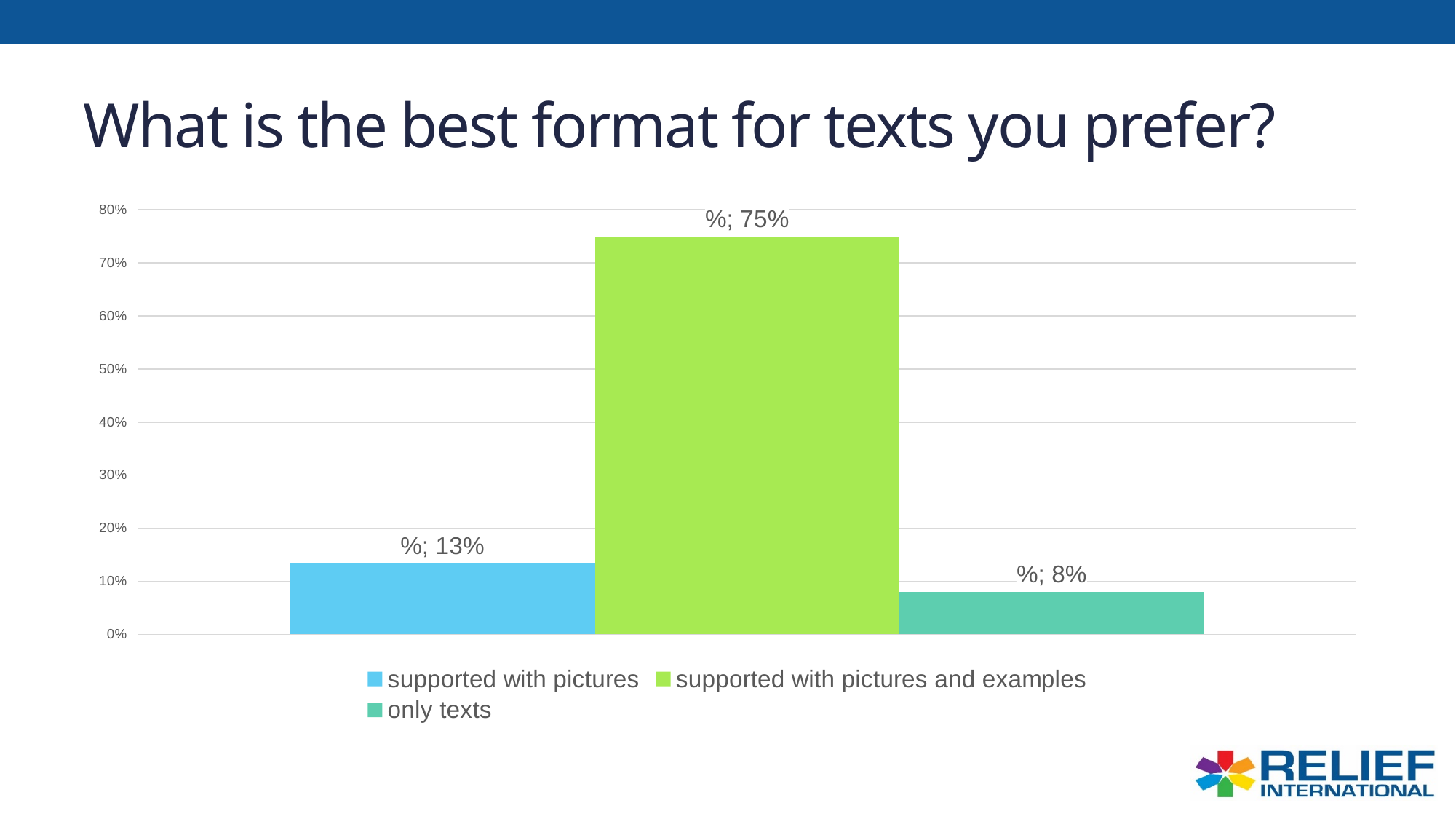
Which category has the lowest value? only texts Which category has the highest value? supported with pictures and examples How many categories does the chart show? 3 Is the value for 'supported with pictures and examples' greater or less than 70%? greater Which is larger, the value for 'supported with pictures' or the value for 'only texts'? supported with pictures What is the difference between the values for 'supported with pictures and examples' and 'supported with pictures'? 62% What is the difference between the values for 'supported with pictures' and 'only texts'? 5% What is the value for 'supported with pictures and examples'? 75% What kind of chart is shown on the slide? bar chart What is the value for 'supported with pictures'? 13% What is the value for 'only texts'? 8% What colour is the bar for 'supported with pictures and examples'? green